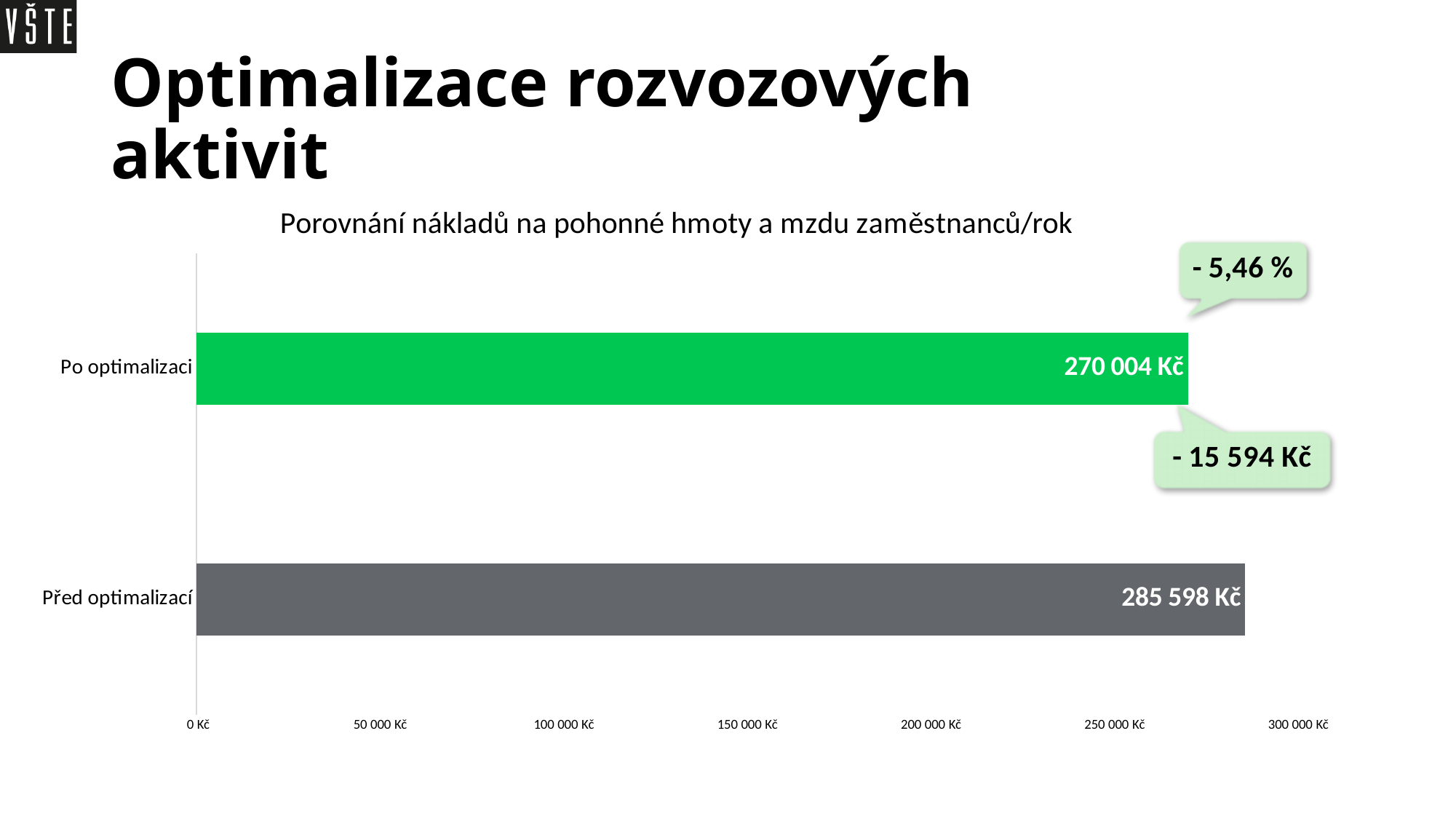
Which category has the higher value? Před optimalizací What kind of chart is shown on the slide? bar chart Which category has the lower value? Po optimalizaci Is the value for "Před optimalizací" greater or less than 300 000 Kč? less Is the value for "Po optimalizaci" larger or smaller than the value for "Před optimalizací"? smaller What percentage change is shown in the callout above the "Po optimalizaci" bar? - 5,46 % What is the title of the chart? Porovnání nákladů na pohonné hmoty a mzdu zaměstnanců/rok What is the difference between the value for "Před optimalizací" and the value for "Po optimalizaci"? 15 594 Kč Is the value for "Po optimalizaci" greater or less than 250 000 Kč? greater What is the value for "Před optimalizací"? 285 598 Kč How many categories are shown in the chart? 2 What is the value for "Po optimalizaci"? 270 004 Kč